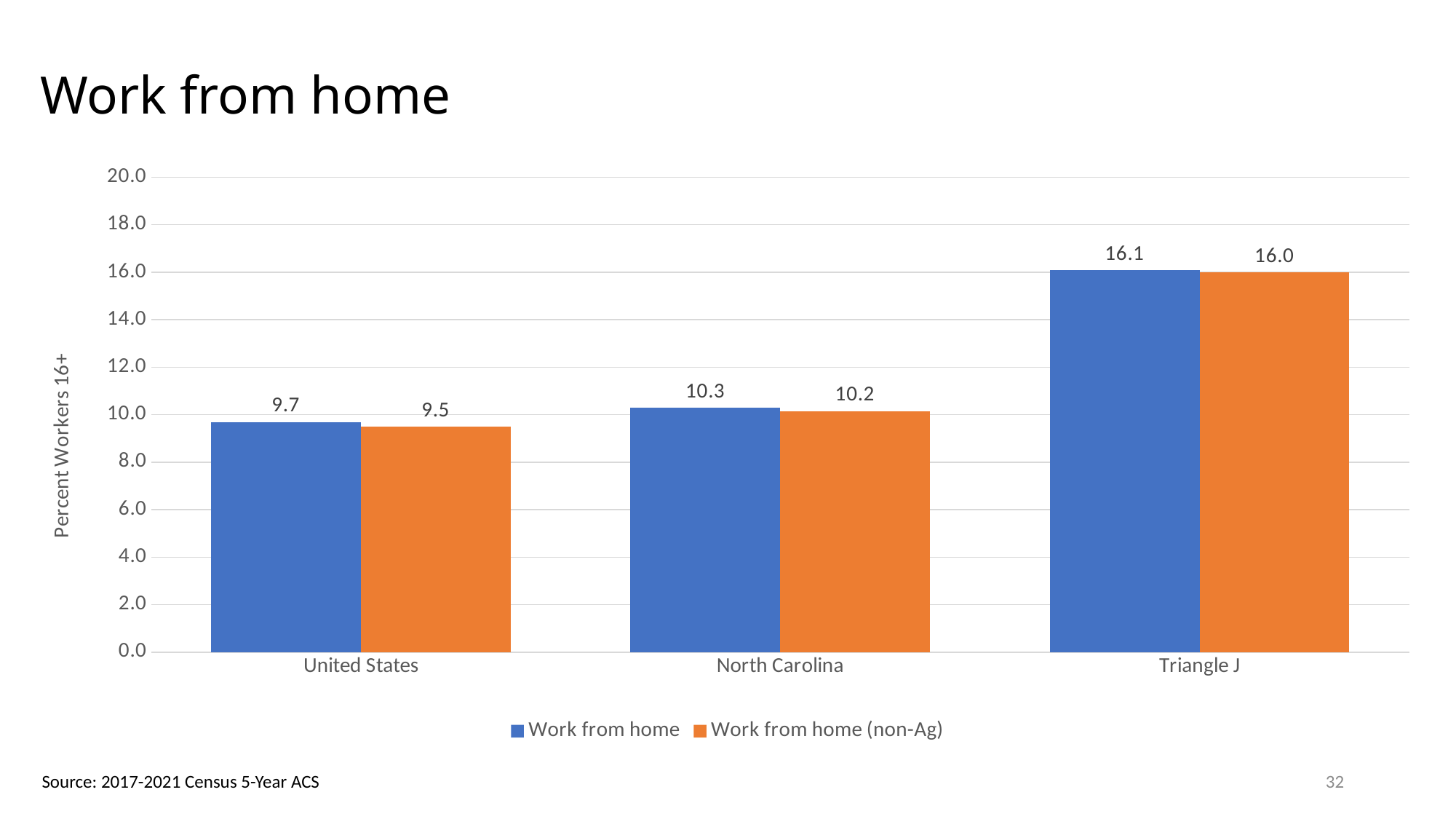
Which category has the lowest Work from home (non-Ag) value? United States How many categories are shown on the x axis? 3 What is the difference between the Work from home and Work from home (non-Ag) values for United States? 0.2 How many series does the legend list? 2 What is the Work from home (non-Ag) value for United States? 9.5 What is the difference between the Work from home values for Triangle J and North Carolina? 5.8 Which is larger: the Work from home value for North Carolina or for United States? North Carolina What is the label of the y axis? Percent Workers 16+ Which category has the highest Work from home value? Triangle J What is the Work from home value for North Carolina? 10.3 What is the Work from home value for Triangle J? 16.1 What kind of chart is shown on the slide? Bar chart